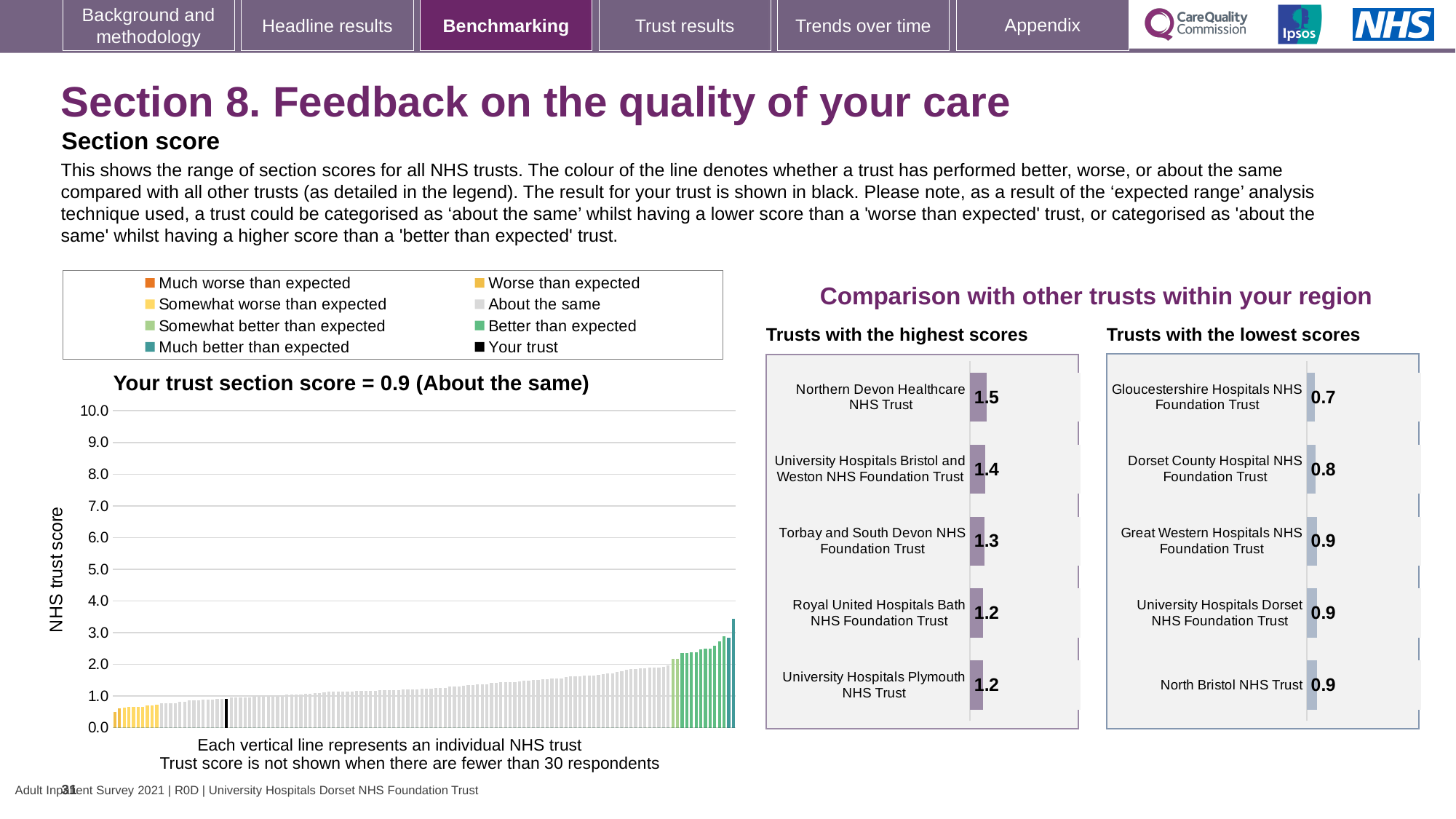
In the 'Trusts with the highest scores' chart, which trust has the highest score? Northern Devon Healthcare NHS Trust In the 'Trusts with the lowest scores' chart, what is the score for Dorset County Hospital NHS Foundation Trust? 0.8 In the 'Your trust section score' chart, is the value of the tallest bar greater or less than 4.0? less In the 'Your trust section score' chart, what is the section score for your trust? 0.9 In the 'Trusts with the highest scores' chart, what is the difference between the scores of Northern Devon Healthcare NHS Trust and Torbay and South Devon NHS Foundation Trust? 0.2 In the 'Trusts with the lowest scores' chart, what is the score for Gloucestershire Hospitals NHS Foundation Trust? 0.7 In the 'Trusts with the highest scores' chart, how many trusts are shown? 5 In the 'Trusts with the highest scores' chart, what is the score for Northern Devon Healthcare NHS Trust? 1.5 In the 'Trusts with the highest scores' chart, what is the score for University Hospitals Plymouth NHS Trust? 1.2 In the 'Trusts with the lowest scores' chart, which has the larger score: Dorset County Hospital NHS Foundation Trust or Gloucestershire Hospitals NHS Foundation Trust? Dorset County Hospital NHS Foundation Trust How many entries does the legend above the 'Your trust section score' chart list? 8 In the 'Trusts with the lowest scores' chart, which trust has the lowest score? Gloucestershire Hospitals NHS Foundation Trust